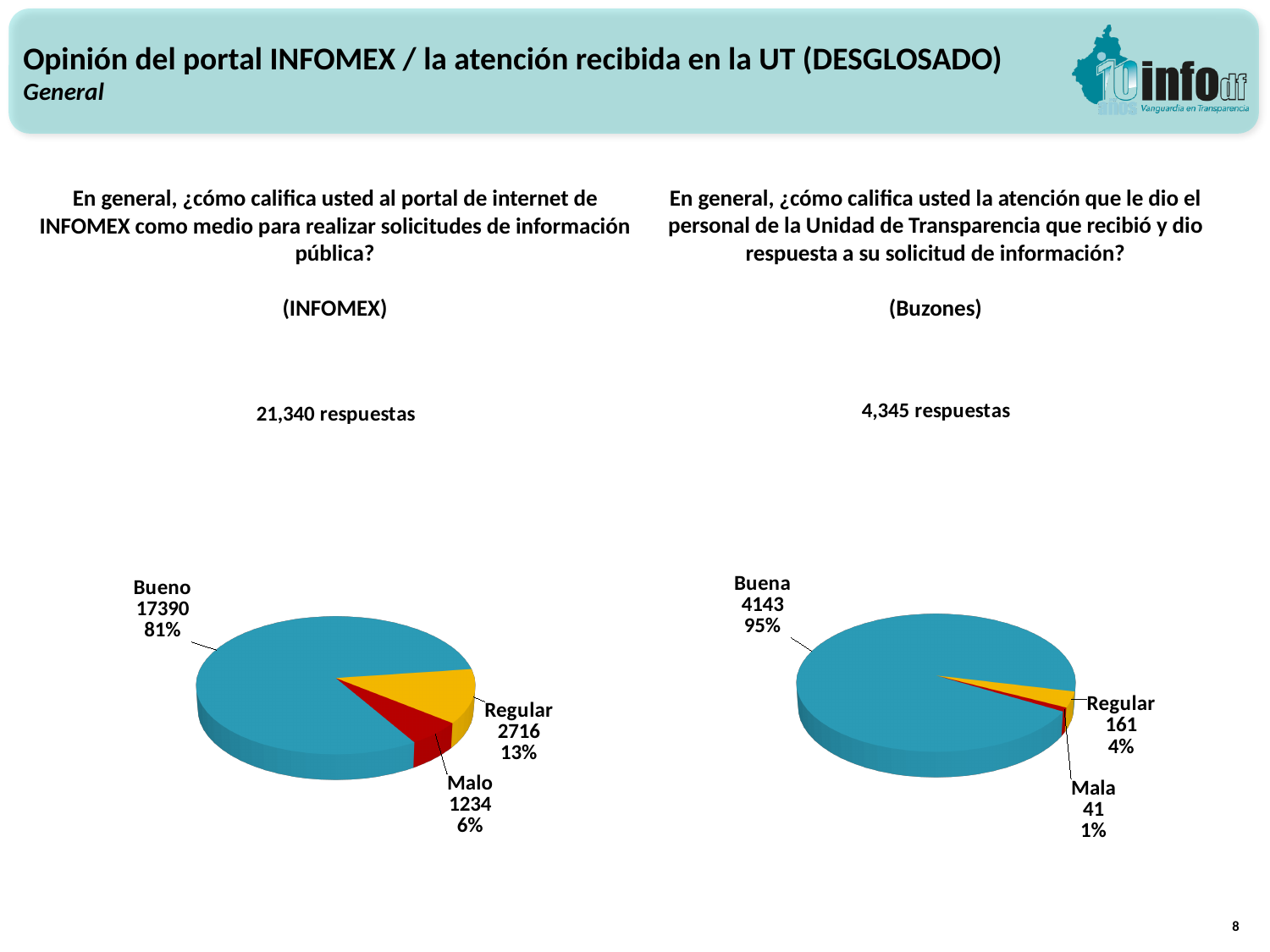
In the Buzones pie chart on the right, how many responses were 'Mala'? 41 In the Buzones pie chart on the right, what is the difference between the 'Regular' and 'Mala' counts? 120 In the INFOMEX pie chart on the left, what percentage of responses were 'Regular'? 13% In the INFOMEX pie chart on the left, which category has the smallest slice? Malo In the Buzones pie chart on the right, what share of responses were 'Buena'? 95% How many total responses does the Buzones chart on the right report? 4,345 respuestas Which is larger: the 'Regular' count in the INFOMEX chart or the 'Regular' count in the Buzones chart? INFOMEX (2716) In the INFOMEX pie chart on the left, what is the difference between the 'Regular' and 'Malo' counts? 1482 In the INFOMEX pie chart on the left, how many responses were 'Bueno'? 17390 What type of chart is used on the right for the Buzones data? Pie chart How many categories does the INFOMEX pie chart on the left show? 3 In the Buzones pie chart on the right, which category has the largest slice? Buena